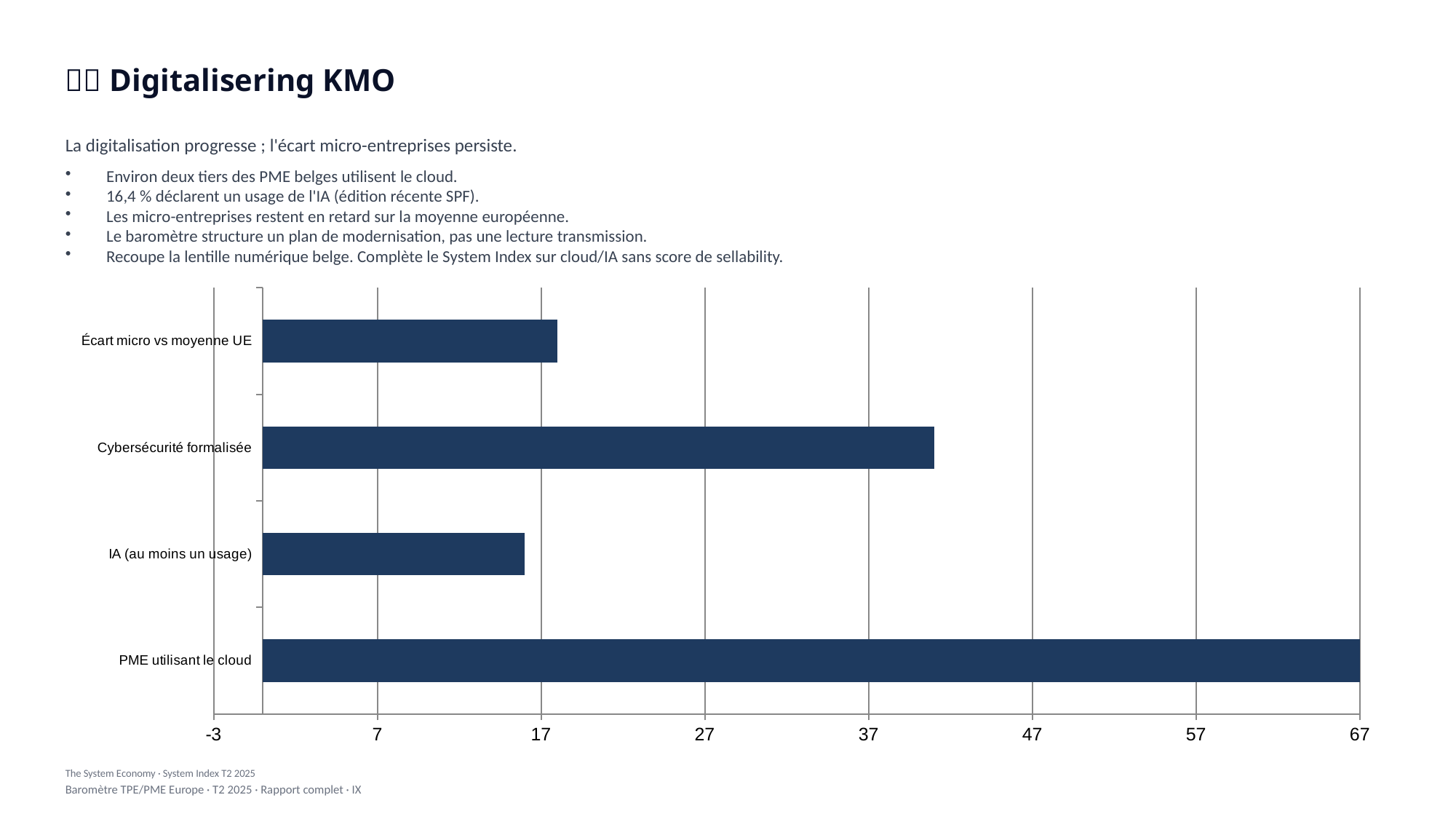
How many categories are plotted in the chart? 4 What is the highest value shown on the chart's horizontal axis? 67 Is the value for Cybersécurité formalisée greater or less than 37? greater Is the value for Écart micro vs moyenne UE greater or less than 27? less Is the value for PME utilisant le cloud greater or less than 57? greater Which category has the lowest value in the chart? IA (au moins un usage) Which is larger: the value for PME utilisant le cloud or the value for Cybersécurité formalisée? PME utilisant le cloud What kind of chart is shown on the slide? bar chart Which is larger: the value for Cybersécurité formalisée or the value for Écart micro vs moyenne UE? Cybersécurité formalisée Which category has the highest value in the chart? PME utilisant le cloud What is the title of the slide containing the chart? Digitalisering KMO